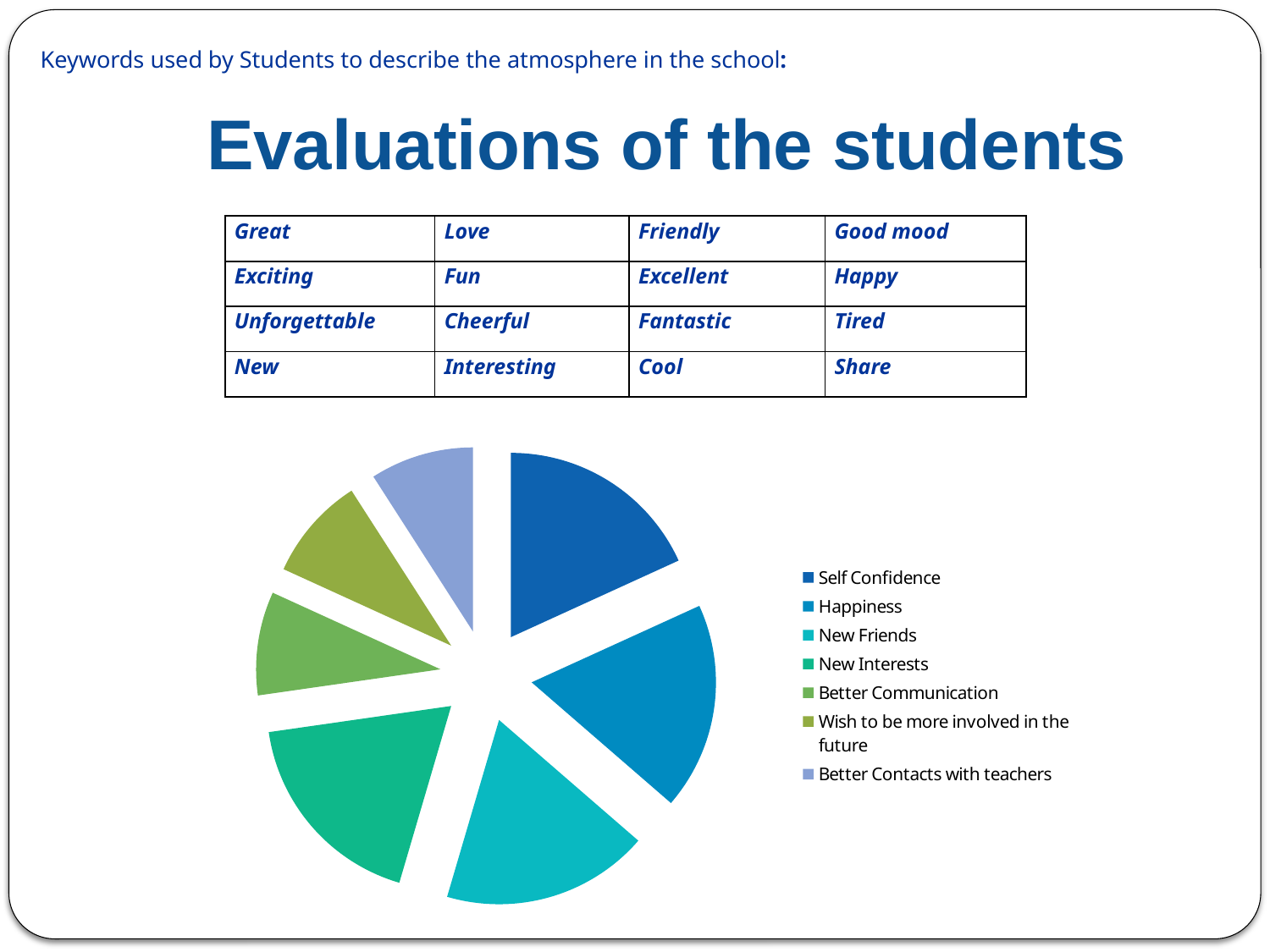
What colour is the Self Confidence slice in the pie chart? dark blue In the pie chart, which slice is larger: New Interests or Wish to be more involved in the future? New Interests In the pie chart, which slice is larger: Happiness or Better Contacts with teachers? Happiness How many slices does the pie chart have? 7 Which entry is listed last in the pie chart's legend? Better Contacts with teachers In the pie chart, which slice is larger: Self Confidence or Wish to be more involved in the future? Self Confidence What kind of chart is shown on the slide? pie chart How many entries does the pie chart's legend list? 7